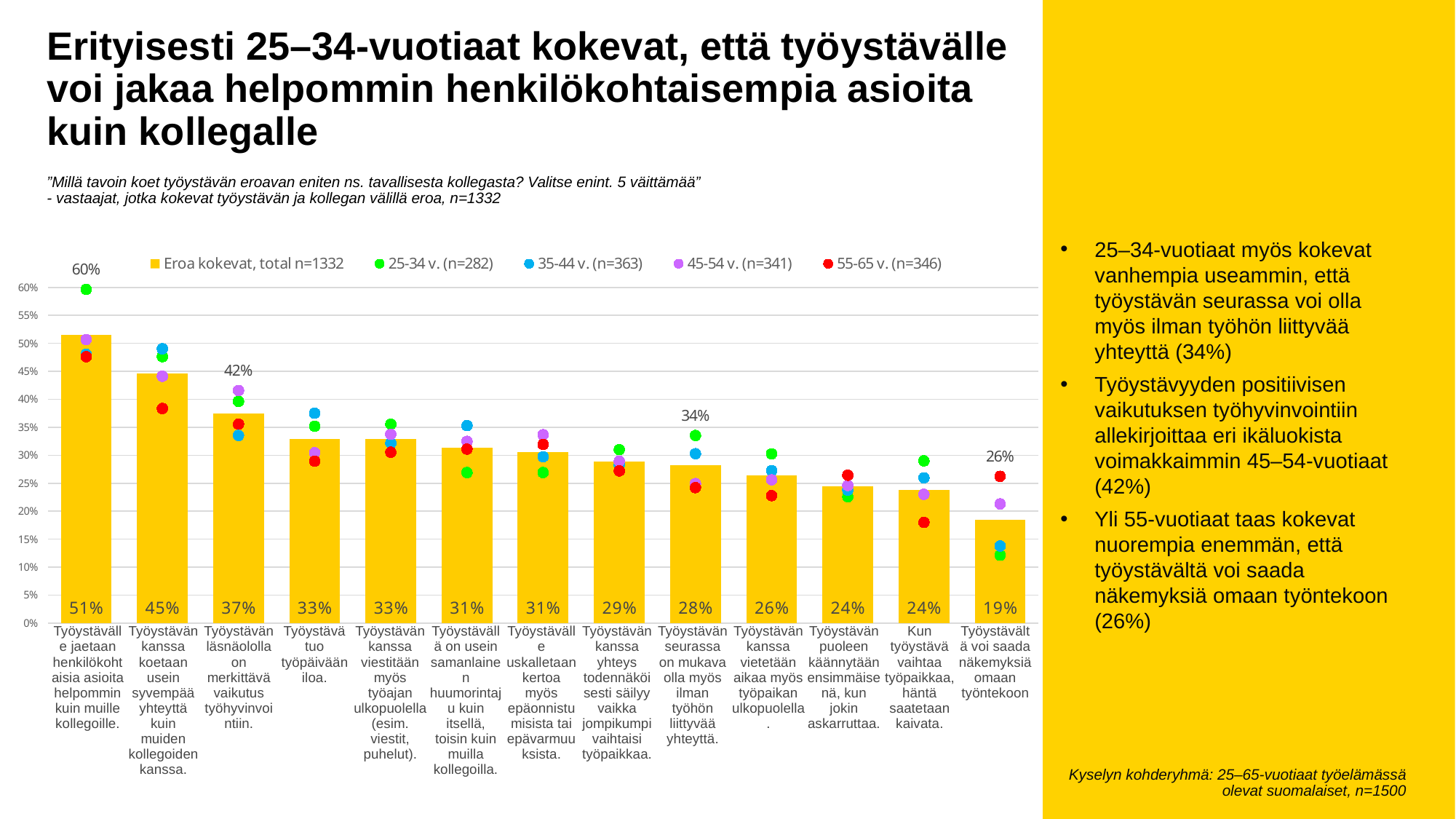
What is the value for 55-65 v. in the category 'Työystävältä voi saada näkemyksiä omaan työntekoon'? 26% What is the value for 25-34 v. in the category 'Työystävälle jaetaan henkilökohtaisia asioita helpommin kuin muille kollegoille'? 60% What kind of chart is shown on the slide? Bar chart What is the total (Eroa kokevat) value for the category 'Työystävän tuo työpäivään iloa'? 33% How many series does the chart legend list? 5 What is the value for 45-54 v. in the category 'Työystävän läsnäololla on merkittävä vaikutus työhyvinvointiin'? 42% Which category has the lowest total (Eroa kokevat) bar? Työystävältä voi saada näkemyksiä omaan työntekoon (19%) How many categories (statements) are shown on the x axis of the chart? 13 Which category has the highest total (Eroa kokevat) bar? Työystävälle jaetaan henkilökohtaisia asioita helpommin kuin muille kollegoille (51%) Is the value for 25-34 v. in the category 'Työystävältä voi saada näkemyksiä omaan työntekoon' greater or less than 15%? less What is the difference between the total bars for 'Työystävälle jaetaan henkilökohtaisia asioita helpommin kuin muille kollegoille' (51%) and 'Työystävän kanssa koetaan usein syvempää yhteyttä kuin muiden kollegoiden kanssa' (45%)? 6 percentage points Do the total (Eroa kokevat) bars rise or fall from left to right along the x axis? Fall